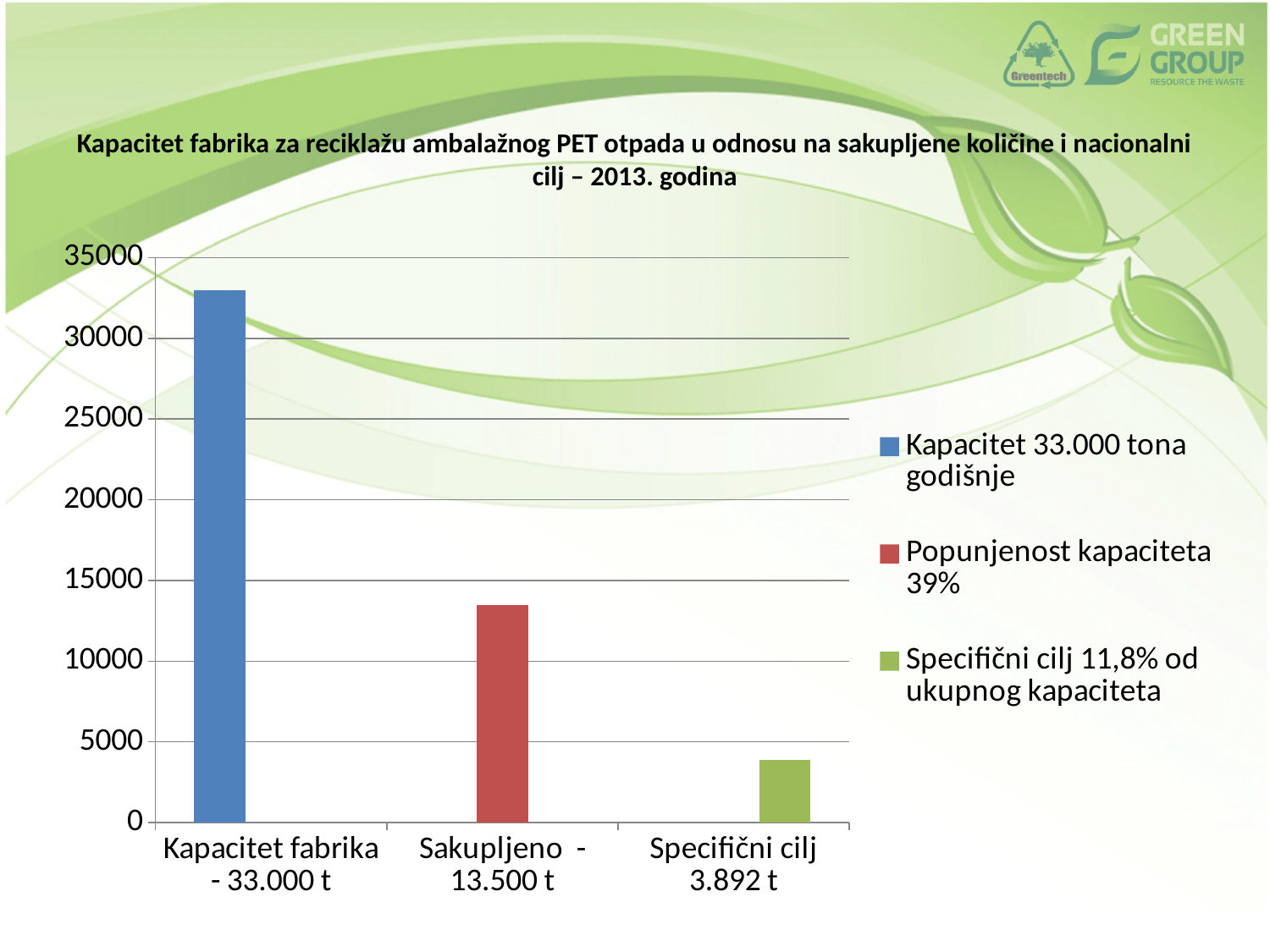
How many entries does the chart legend list? 3 What value is given for 'Kapacitet fabrika' in the category label? 33.000 t What percentage is given in the legend entry 'Popunjenost kapaciteta'? 39% Which is larger, the value for 'Sakupljeno' or the value for 'Specifični cilj'? Sakupljeno Is the value for 'Sakupljeno' greater or less than 15000? less What value is given for 'Specifični cilj' in the category label? 3.892 t How many bars are plotted in the chart? 3 What value is given for 'Sakupljeno' in the category label? 13.500 t Is the value for 'Kapacitet fabrika' greater or less than 30000? greater Which category has the lowest bar? Specifični cilj What kind of chart is shown on the slide? bar chart Which category has the highest bar? Kapacitet fabrika